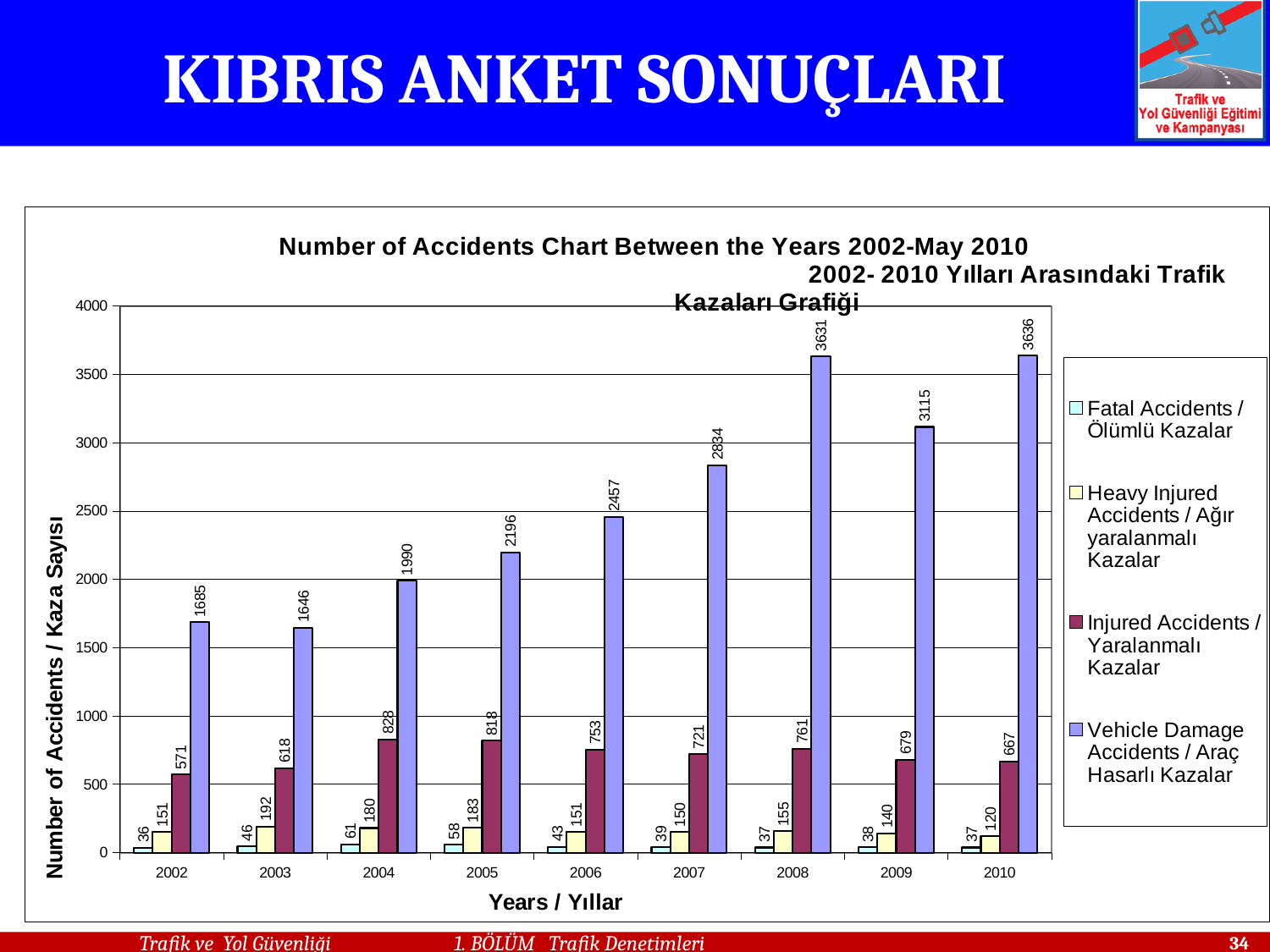
How many series does the legend list? 4 Which is larger: Injured Accidents in 2004 or Injured Accidents in 2005? 2004 In which year is the value for Fatal Accidents lowest? 2002 What is the value for Injured Accidents in 2009? 679 What is the value for Vehicle Damage Accidents in 2008? 3631 In which year is the value for Vehicle Damage Accidents highest? 2010 What type of chart is shown on the slide? Bar chart What is the difference between Vehicle Damage Accidents in 2010 and in 2002? 1951 How many years are shown on the x axis? 9 What is the value for Heavy Injured Accidents in 2003? 192 What is the value for Fatal Accidents in 2004? 61 What is the label of the y axis? Number of Accidents / Kaza Sayısı